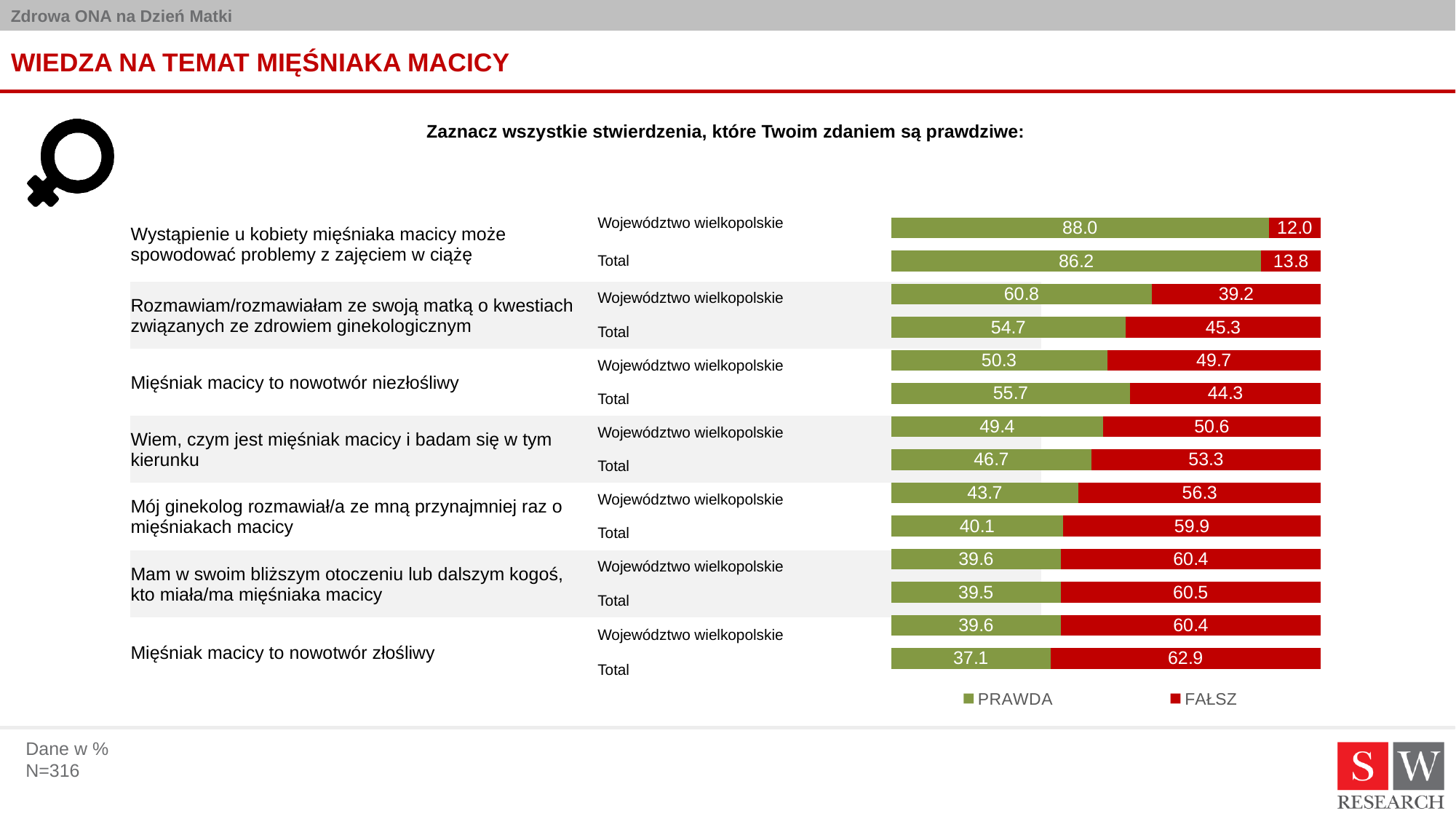
What is the total of the stacked bar for 'Total' for the statement 'Mój ginekolog rozmawiał/a ze mną przynajmniej raz o mięśniakach macicy'? 100.0 Which colour represents FAŁSZ in the chart? Red What is the PRAWDA value for 'Województwo wielkopolskie' for the statement 'Wystąpienie u kobiety mięśniaka macicy może spowodować problemy z zajęciem w ciążę'? 88.0 For the statement 'Mięśniak macicy to nowotwór niezłośliwy', which has the larger PRAWDA value: 'Województwo wielkopolskie' or 'Total'? Total What is the FAŁSZ value for 'Total' for the statement 'Mięśniak macicy to nowotwór złośliwy'? 62.9 Which bar has the lowest PRAWDA value? Total, 'Mięśniak macicy to nowotwór złośliwy' What is the difference between the PRAWDA values for 'Województwo wielkopolskie' and 'Total' for the statement 'Rozmawiam/rozmawiałam ze swoją matką o kwestiach związanych ze zdrowiem ginekologicznym'? 6.1 What is the PRAWDA value for 'Total' for the statement 'Rozmawiam/rozmawiałam ze swoją matką o kwestiach związanych ze zdrowiem ginekologicznym'? 54.7 What kind of chart is shown on the slide? Stacked bar chart How many series does the legend list? 2 How many statements are shown in the chart? 7 Which bar has the highest PRAWDA value? Województwo wielkopolskie, 'Wystąpienie u kobiety mięśniaka macicy może spowodować problemy z zajęciem w ciążę'